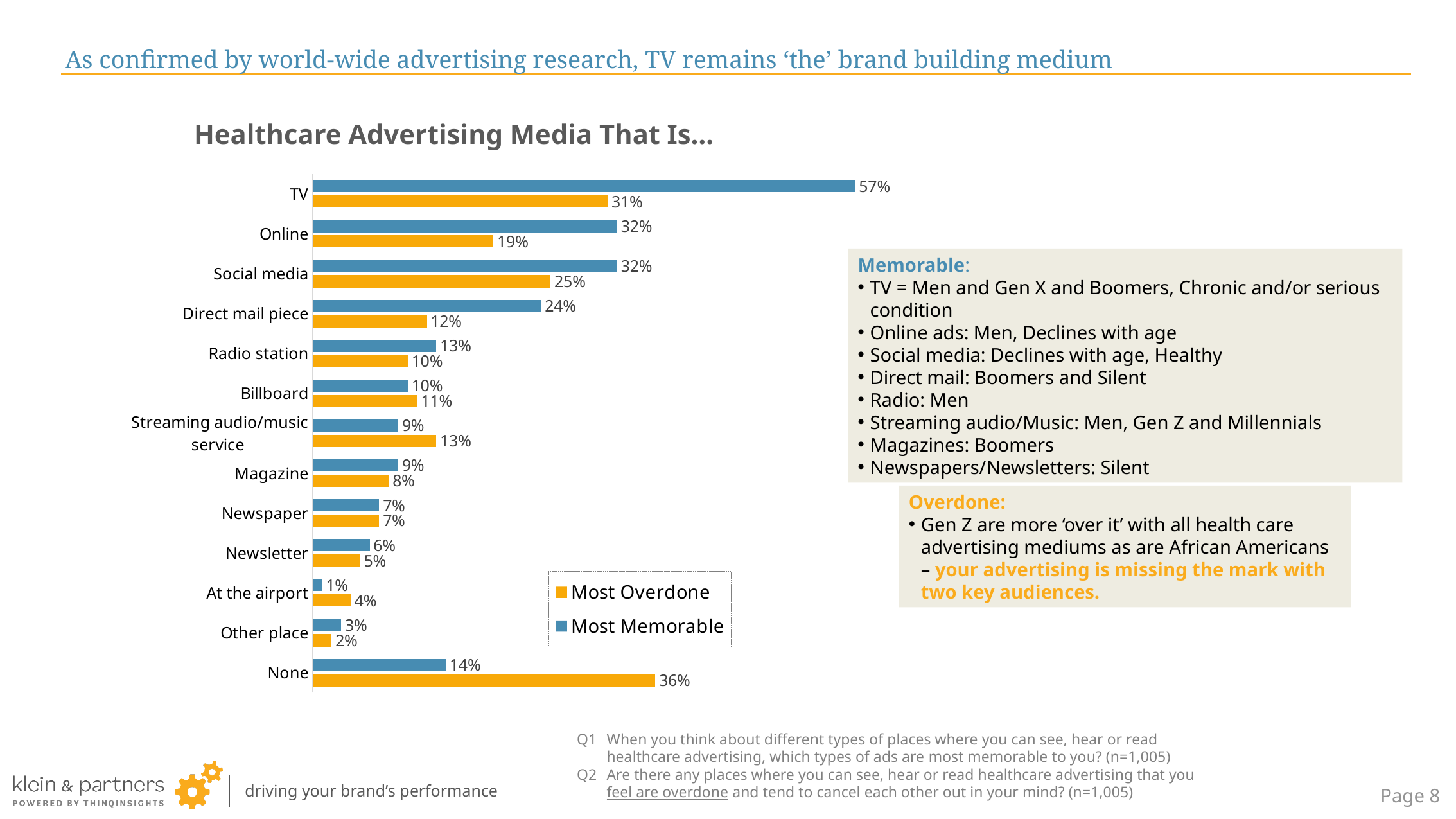
How many categories are shown on the chart? 13 What is the Most Overdone value for None? 36% What percentage of respondents said TV is the most memorable healthcare advertising medium? 57% Which category has the highest Most Memorable value? TV What is the Most Memorable value for Direct mail piece? 24% What is the Most Overdone value for Social media? 25% Which category has the lowest Most Memorable value? At the airport What type of chart is shown on the slide? Bar chart For Streaming audio/music service, which is larger: Most Overdone or Most Memorable? Most Overdone Which category has the highest Most Overdone value? None What is the difference between the Most Memorable and Most Overdone values for TV? 26% How many series does the legend list? 2